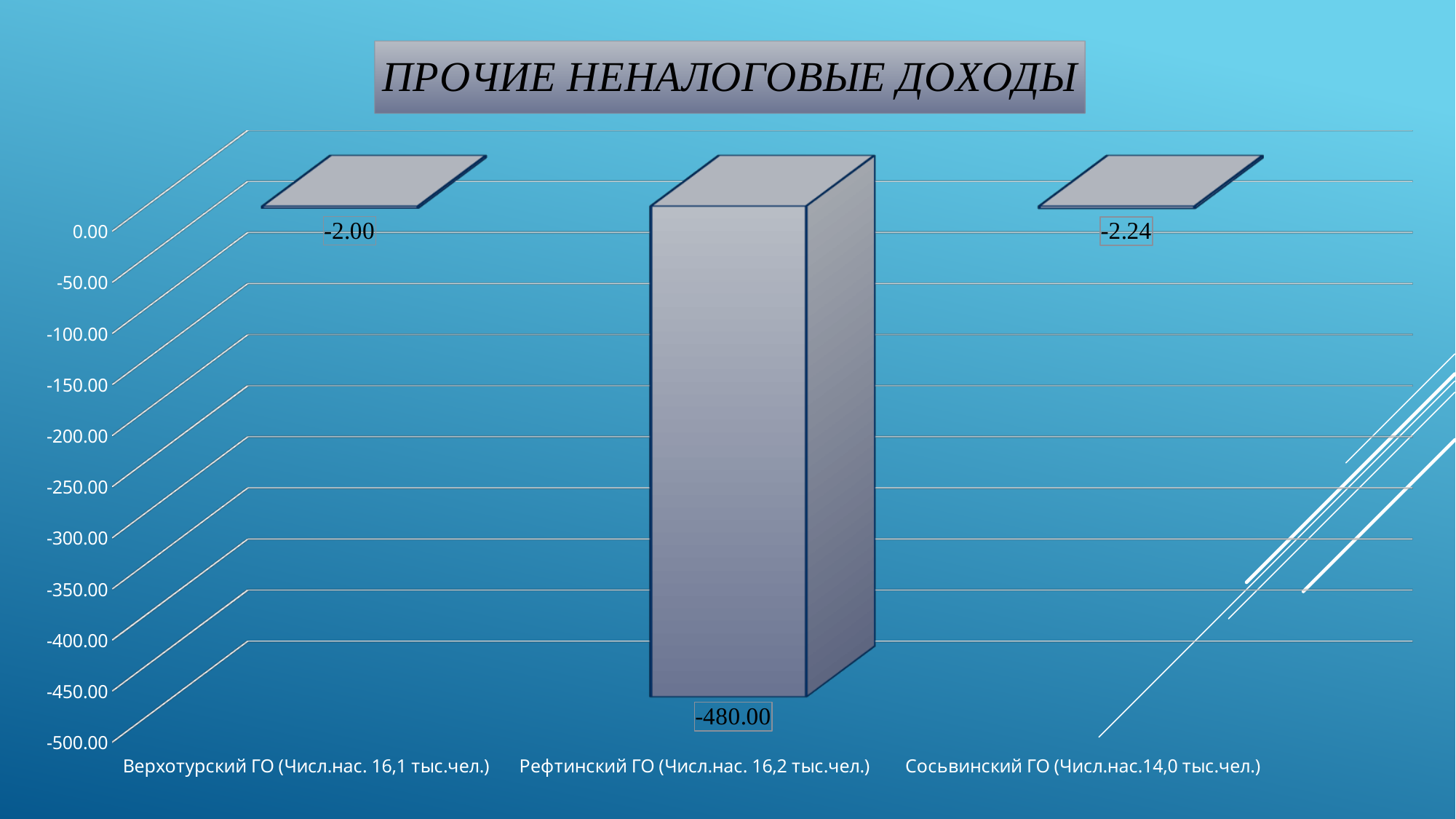
What kind of chart is shown on the slide? bar chart What is the value for Верхотурский ГО? -2.00 What is the value for Сосьвинский ГО? -2.24 Which category has the highest value? Верхотурский ГО What is the value for Рефтинский ГО? -480.00 Is the value for Рефтинский ГО greater or less than -400.00? less What is the title of the chart? ПРОЧИЕ НЕНАЛОГОВЫЕ ДОХОДЫ How many categories are shown on the chart? 3 What is the difference between the values for Верхотурский ГО and Рефтинский ГО? 478.00 Which category has the lowest value? Рефтинский ГО Which is larger, the value for Рефтинский ГО or the value for Сосьвинский ГО? Сосьвинский ГО What is the difference between the values for Верхотурский ГО and Сосьвинский ГО? 0.24